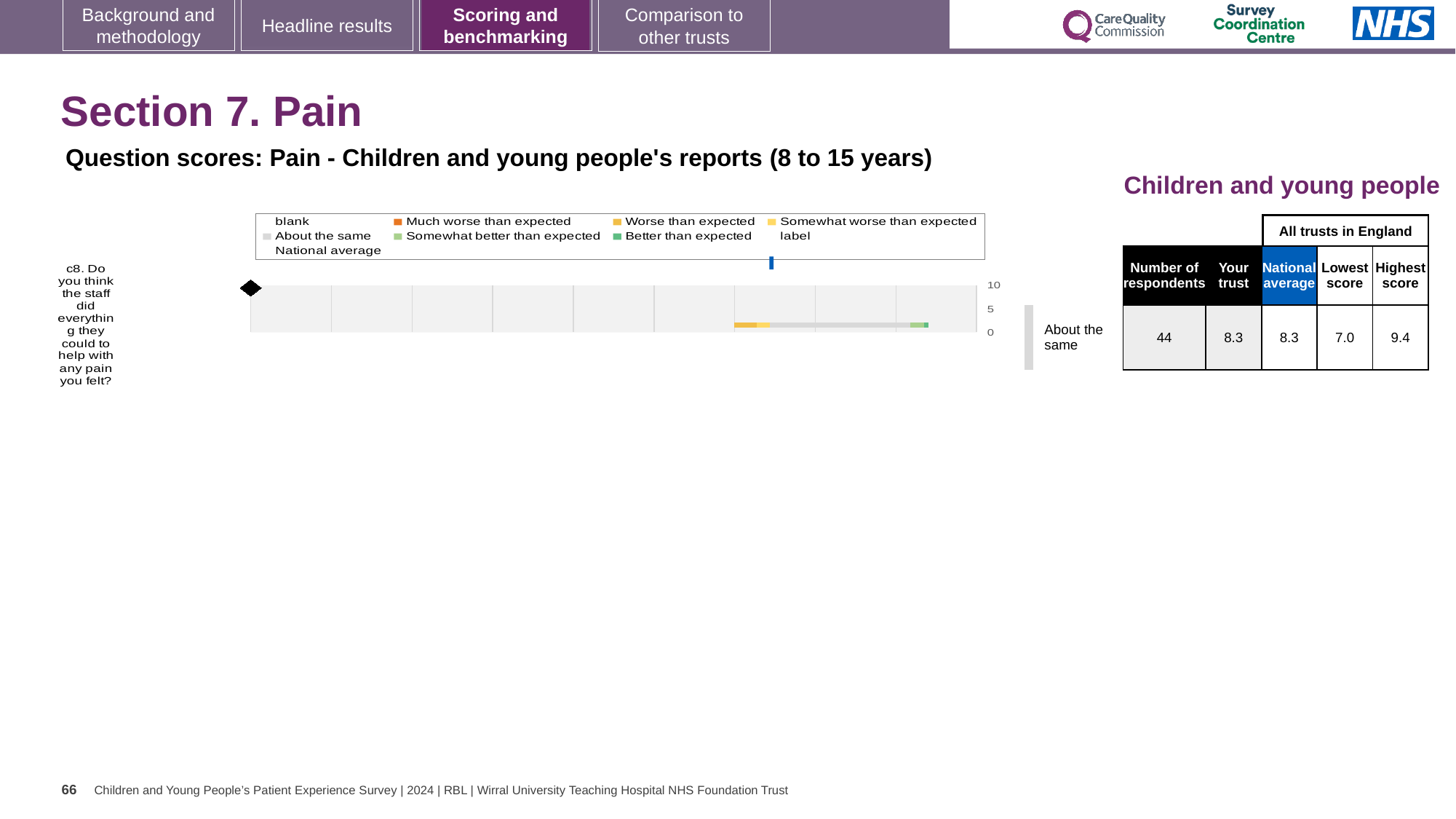
What kind of chart is shown on the slide? bar chart How many respondents answered question c8? 44 Which is larger for question c8: the trust's score or the national average? They are equal (8.3) What benchmark category is the trust's result for question c8 assigned to? About the same According to the table, what is the lowest score among all trusts in England for question c8? 7.0 What is the difference between the highest and lowest scores for question c8 in the table? 2.4 According to the table, what is the 'Your trust' score for question c8? 8.3 According to the table, what is the national average score for question c8? 8.3 What colour does the legend use for 'Better than expected'? green How many questions (categories) are plotted in the chart? 1 According to the table, what is the highest score among all trusts in England for question c8? 9.4 Which question is plotted in the chart? c8. Do you think the staff did everything they could to help with any pain you felt?